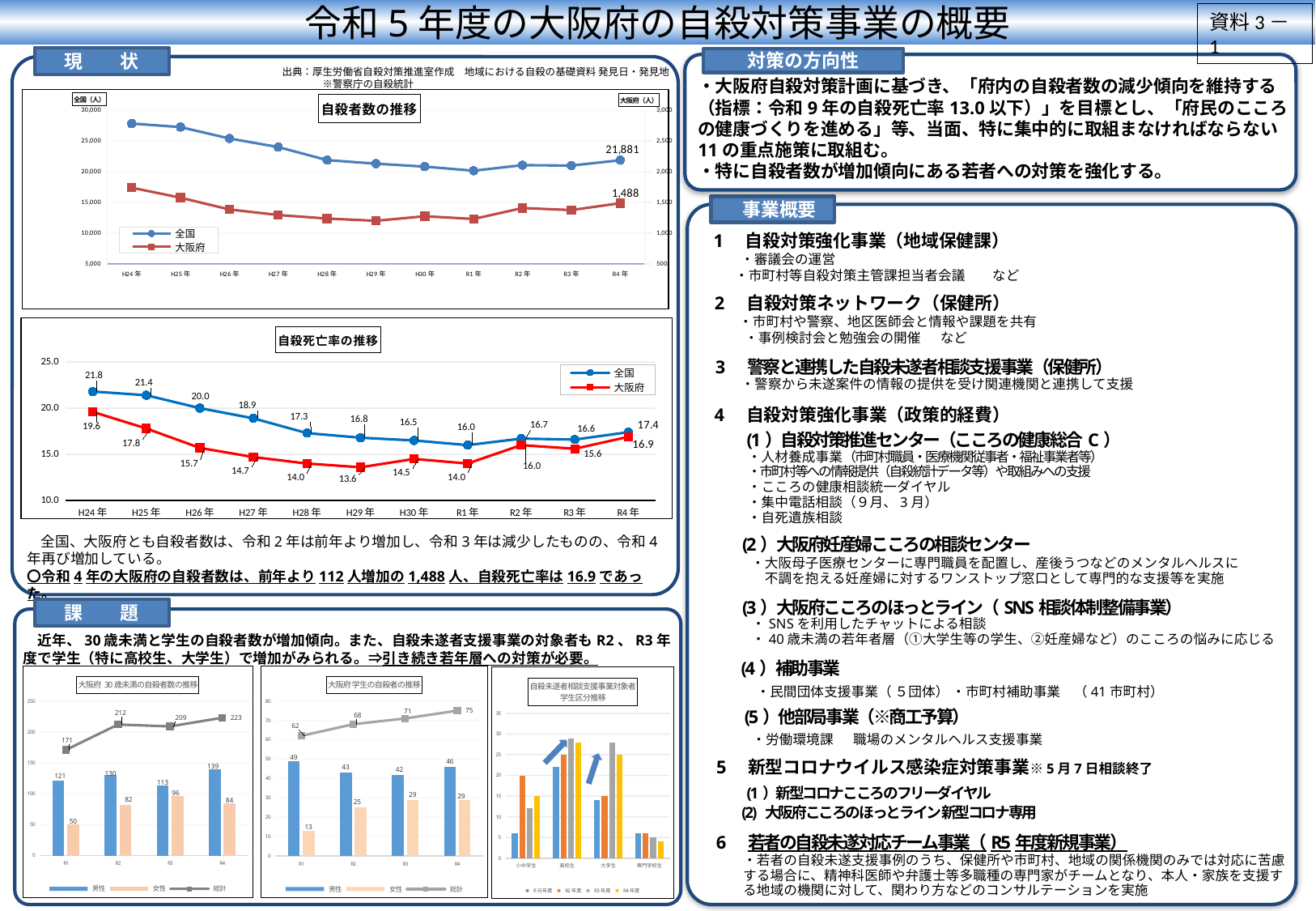
In the 大阪府学生の自殺者の推移 chart, does the 総計 line rise or fall from R1 to R4? rise In the 自殺者数の推移 chart, what is the value for 全国 in R4年? 21,881 In the 自殺死亡率の推移 chart, which year has the lowest value for 大阪府? H29年 In the 自殺者数の推移 chart, what is the value for 大阪府 in R4年? 1,488 In the 大阪府 30歳未満の自殺者数の推移 chart, what is the difference between 男性 and 女性 in R1? 71 In the 自殺未遂者相談支援事業対象者 学生区分推移 chart, how many categories are shown on the x axis? 4 In the 大阪府学生の自殺者の推移 chart, what is the 女性 value for R1? 13 In the 大阪府 30歳未満の自殺者数の推移 chart, what is the 総計 value for R4? 223 In the 自殺死亡率の推移 chart, what is the value for 大阪府 in H29年? 13.6 In the 自殺死亡率の推移 chart, how many series does the legend list? 2 In the 大阪府 30歳未満の自殺者数の推移 chart, which year has the highest 女性 value? R3 In the 自殺死亡率の推移 chart, what is the difference between 全国 and 大阪府 in R4年? 0.5